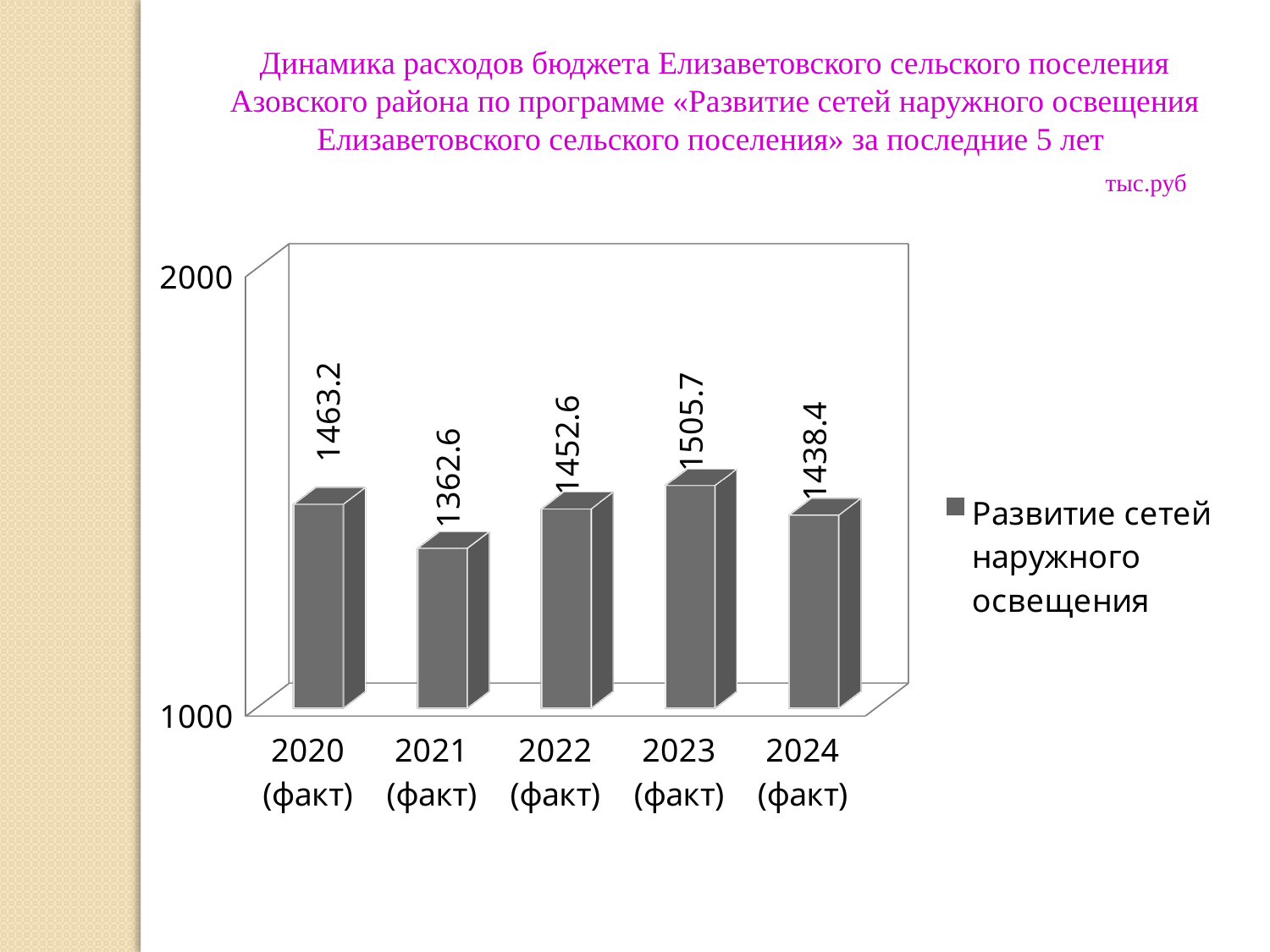
What series name does the legend show? Развитие сетей наружного освещения Which is larger, the value for 2020 (факт) or the value for 2022 (факт)? 2020 (факт) What is the value for 2021 (факт)? 1362.6 Which year has the lowest value? 2021 (факт) Is the value for 2023 (факт) greater or less than 2000? less What is the value for 2023 (факт)? 1505.7 What is the difference between the values for 2023 (факт) and 2021 (факт)? 143.1 What is the value for 2020 (факт)? 1463.2 How many years are shown on the x axis? 5 Which year has the highest value? 2023 (факт) What kind of chart is shown on the slide? bar chart What is the value for 2024 (факт)? 1438.4